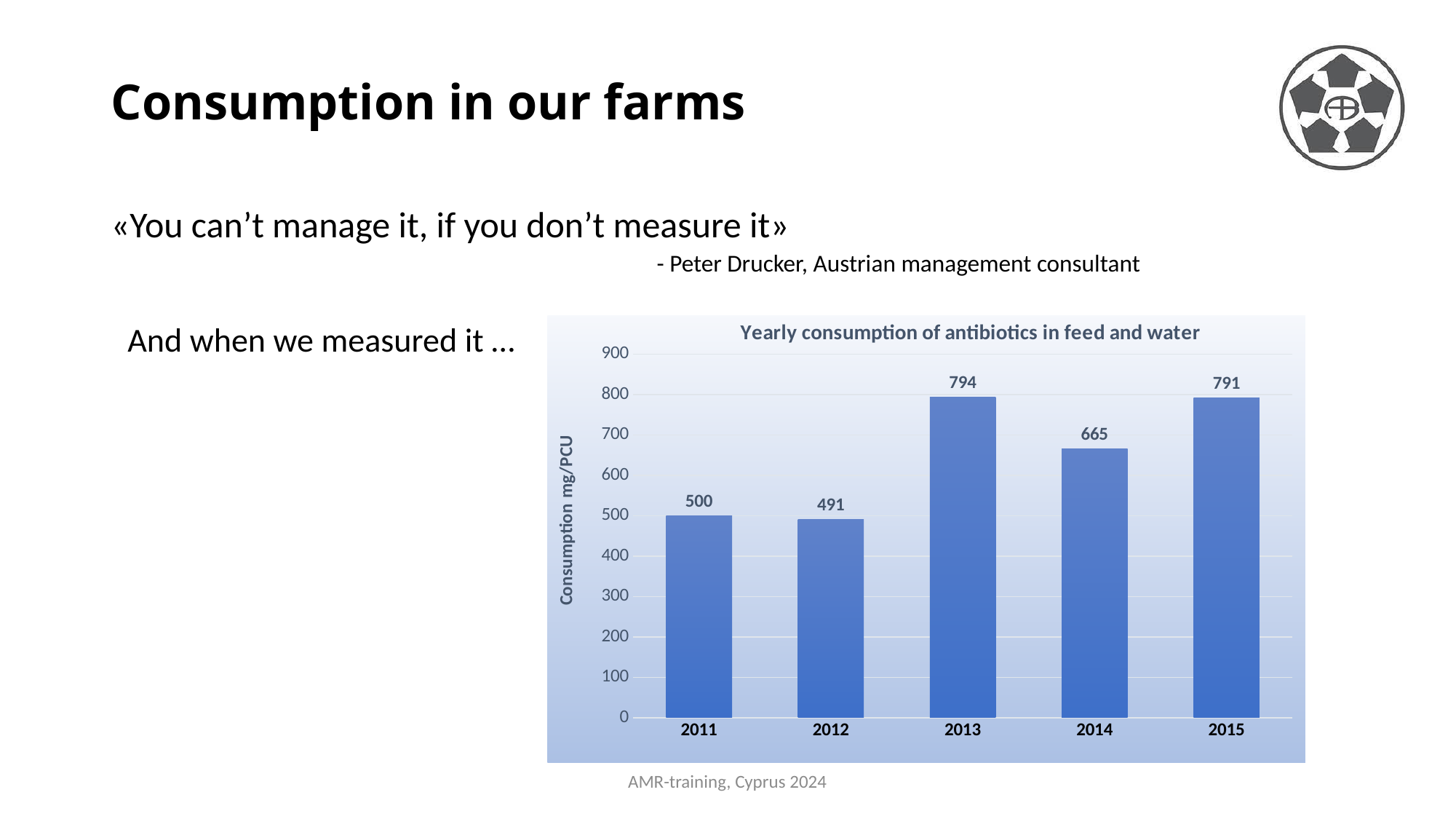
What kind of chart is shown on the slide? Bar chart What is the difference between the consumption in 2013 and 2014? 129 Which year has the lowest consumption? 2012 Is the value for 2014 greater or less than 600? greater What is the consumption value for 2014? 665 What is the difference between the consumption in 2011 and 2012? 9 How many years are shown on the chart? 5 What is the consumption value for 2011? 500 What is the title of the chart? Yearly consumption of antibiotics in feed and water Which year has the larger consumption, 2014 or 2015? 2015 Which year has the highest consumption? 2013 What is the consumption value for 2013? 794